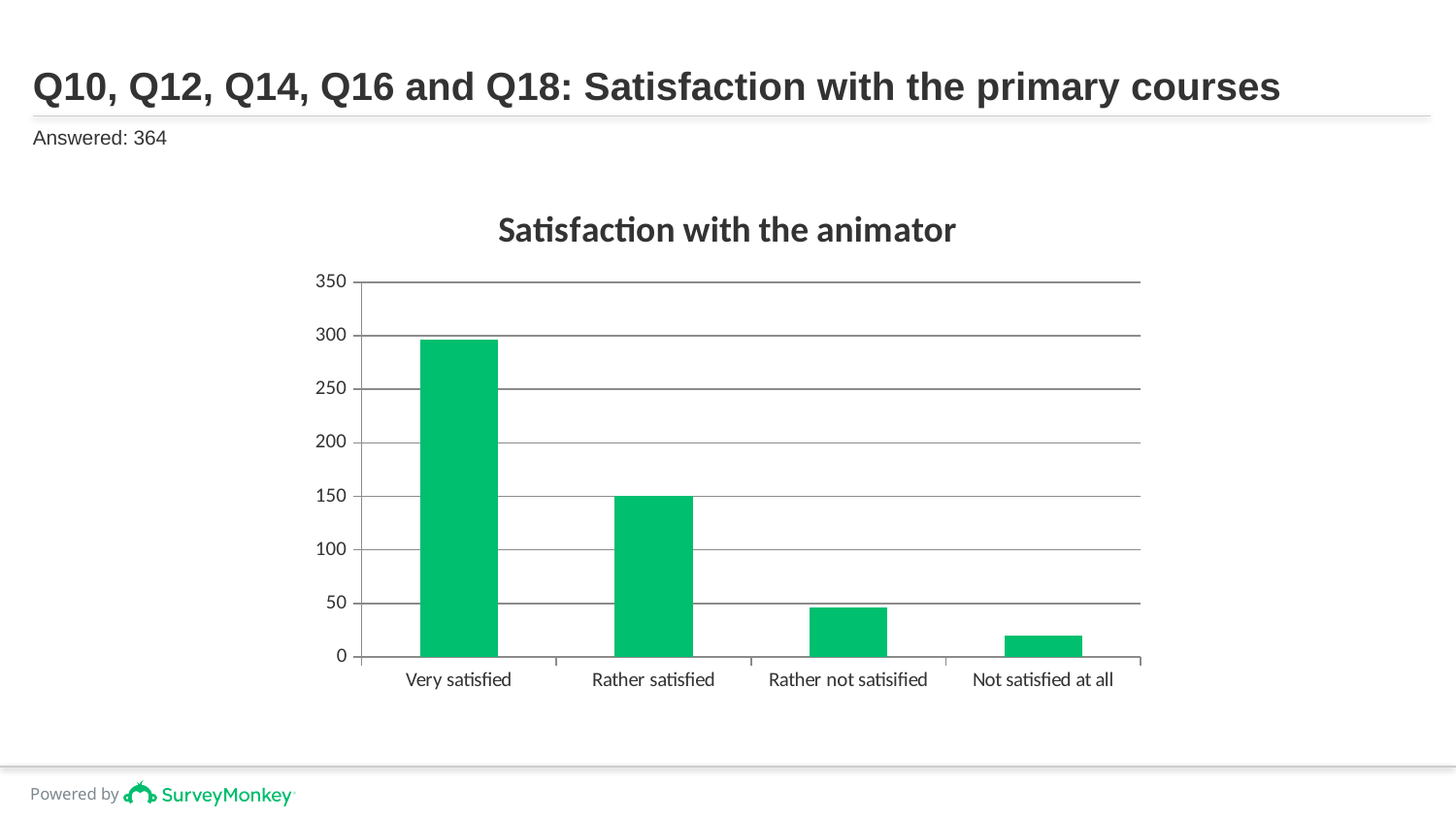
Is the value for Very satisfied greater or less than 250? greater Which category has the lowest value? Not satisfied at all Is the value for Rather not satisified greater or less than 100? less How many categories are shown on the x axis of the chart? 4 Do the values rise or fall moving from left to right along the x axis? fall Which category has the highest value? Very satisfied Is the value for Not satisfied at all greater or less than 50? less What is the title of the chart? Satisfaction with the animator Which is larger, the value for Rather satisfied or the value for Rather not satisified? Rather satisfied What colour are the bars in the chart? green What kind of chart is shown on the slide? bar chart